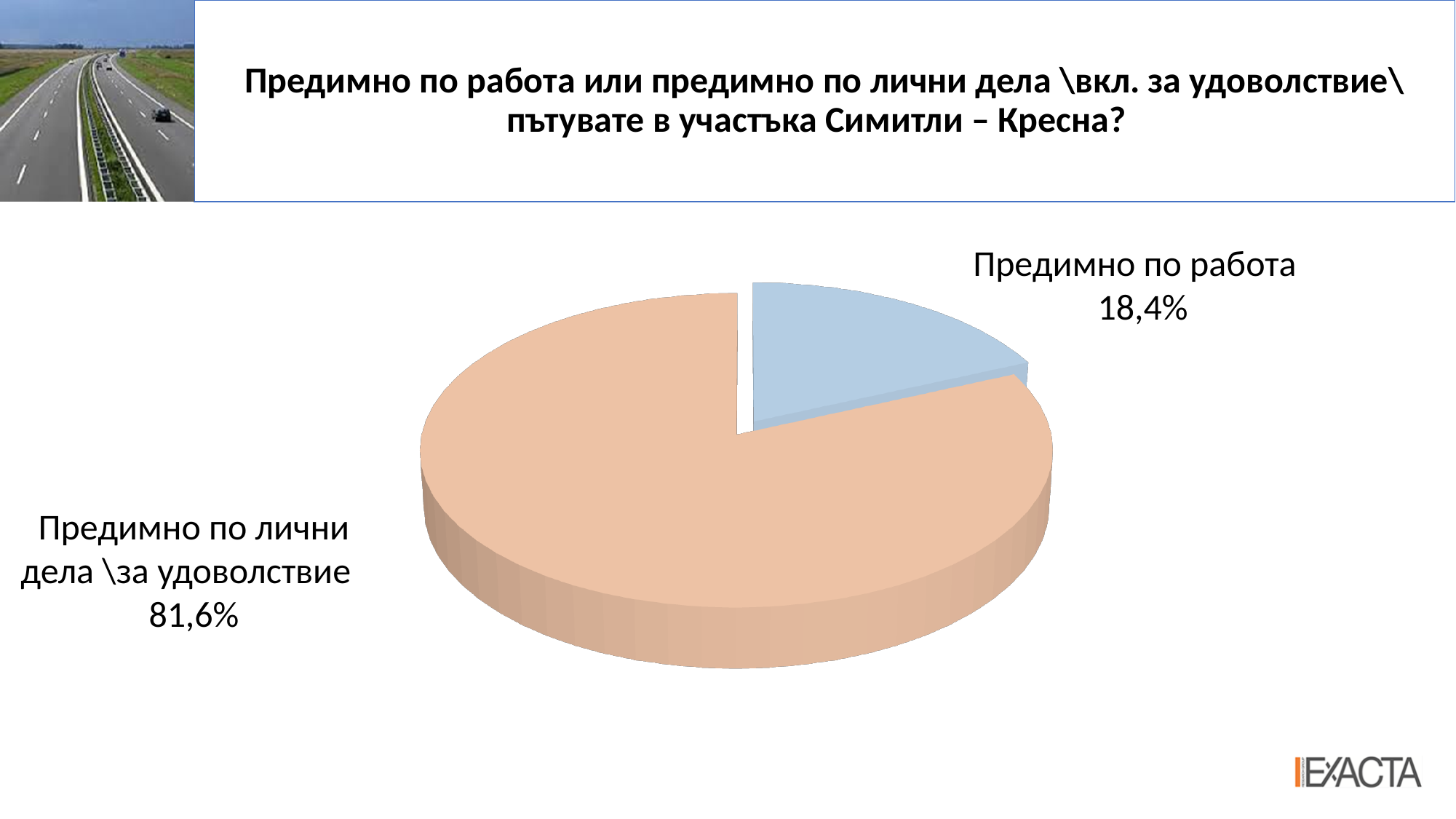
What kind of chart is shown on the slide? pie chart What is the difference in percentage points between the "Предимно по лични дела \за удоволствие" slice and the "Предимно по работа" slice? 63,2 Which slice of the pie is the smallest? Предимно по работа Which slice of the pie is the largest? Предимно по лични дела \за удоволствие What share of the pie is labelled "Предимно по работа"? 18,4% What colour is the "Предимно по работа" slice? light blue What share of the pie is labelled "Предимно по лични дела \за удоволствие"? 81,6% Is the share for "Предимно по работа" greater or less than 50%? less What is the title of the chart on the slide? Предимно по работа или предимно по лични дела \вкл. за удоволствие\ пътувате в участъка Симитли – Кресна? How many slices does the pie chart have? 2 Which is larger: the share for "Предимно по работа" or the share for "Предимно по лични дела \за удоволствие"? Предимно по лични дела \за удоволствие